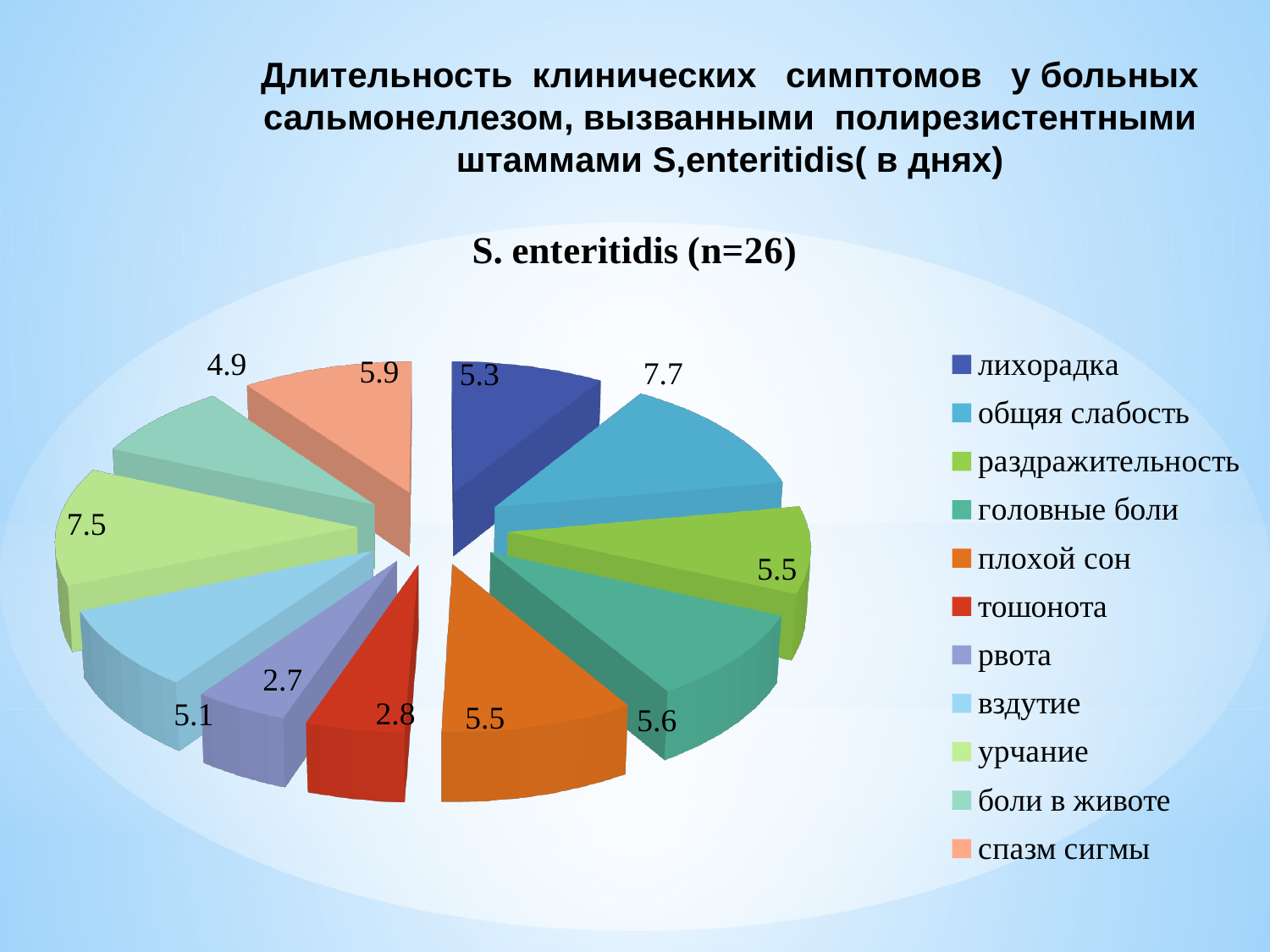
What is the title of the chart? S. enteritidis (n=26) How many categories does the pie chart show? 11 What is the value for спазм сигмы? 5.9 Which is larger, the value for головные боли or the value for вздутие? головные боли What kind of chart is shown on the slide? pie chart What is the value for рвота? 2.7 Which category has the lowest value? рвота What is the difference between the values for общяя слабость and рвота? 5.0 What is the value for урчание? 7.5 What is the value for лихорадка? 5.3 What is the value for общяя слабость? 7.7 Which category has the highest value? общяя слабость